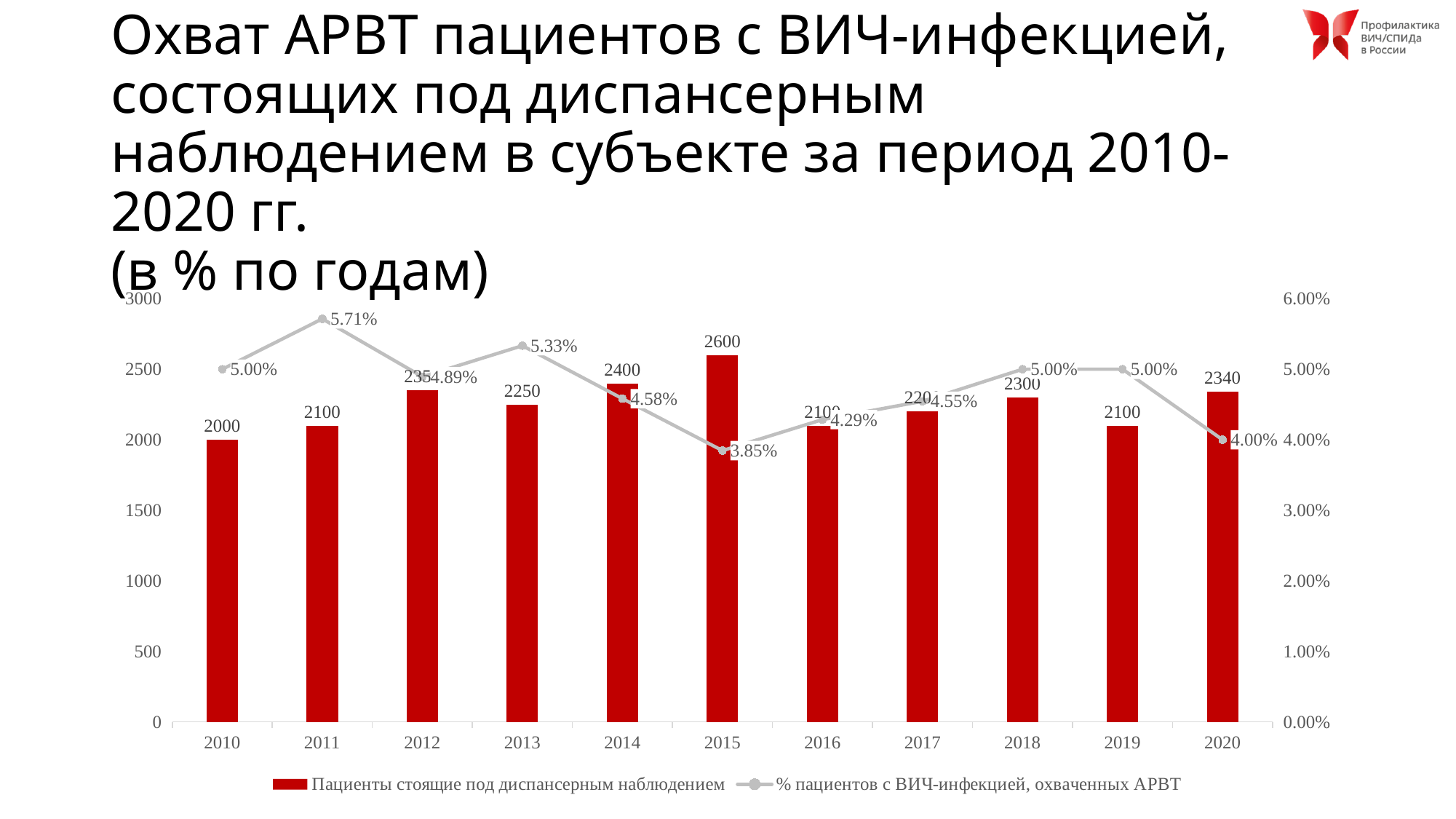
Which year has the highest bar for patients under dispensary observation? 2015 What is the value of the bar for 2020? 2340 What is the value of the bar for 2015? 2600 What is the difference between the bar values for 2015 and 2010? 600 Which year has the lowest bar for patients under dispensary observation? 2010 Which is larger, the bar value for 2014 or for 2018? 2014 What colour are the bars in the chart? Red What percentage of patients with HIV infection were covered by ARVT in 2015? 3.85% How many series does the legend list? 2 In which year is the percentage of patients covered by ARVT the lowest? 2015 How many years are shown on the x axis? 11 What percentage of patients with HIV infection were covered by ARVT in 2011? 5.71%